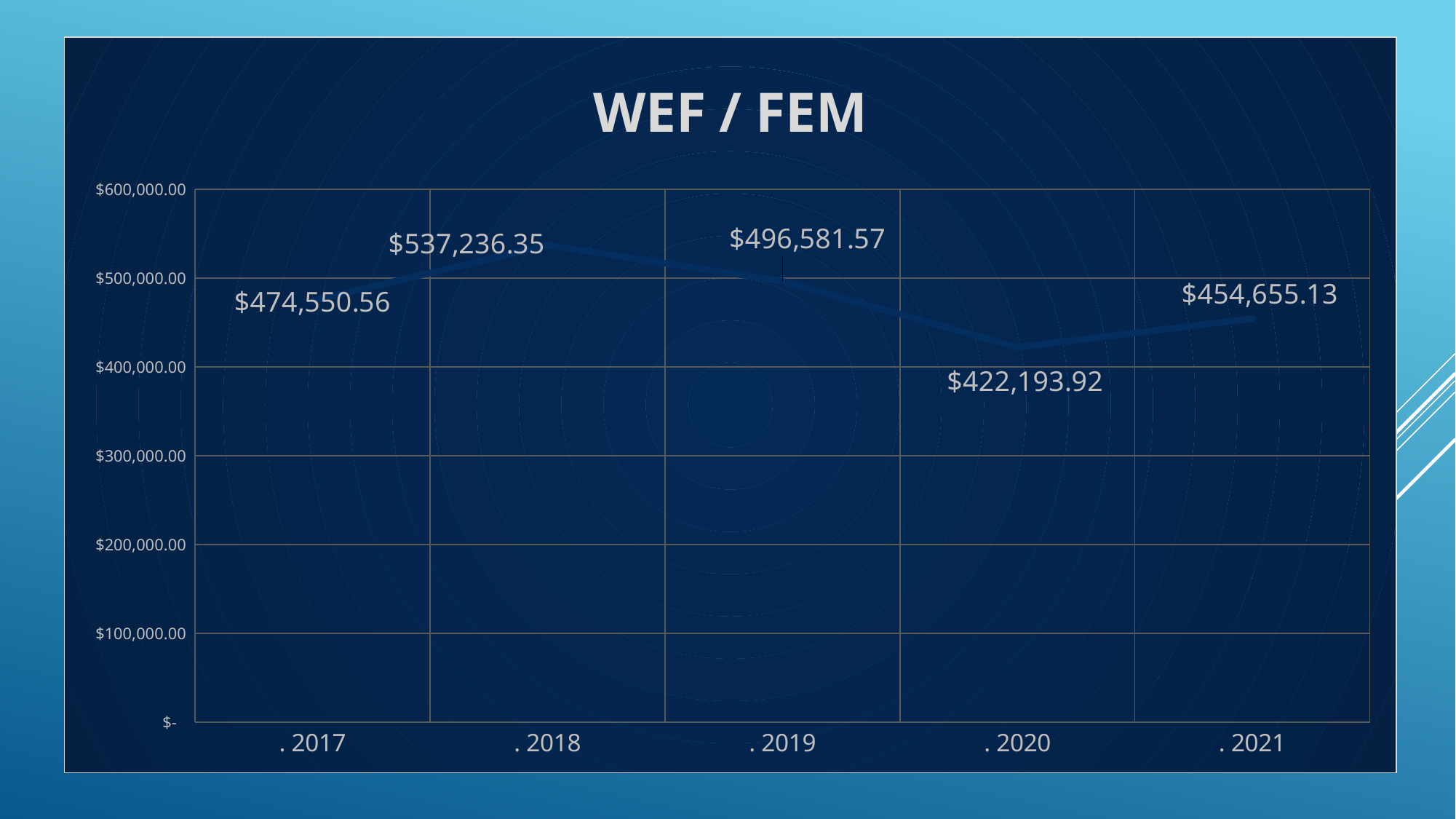
Which year has the lowest value? 2020 What is the difference between the 2019 value and the 2020 value? $74,387.65 Which year has the highest value? 2018 What is the value for 2020? $422,193.92 How many years are plotted on the x axis? 5 What is the value for 2018? $537,236.35 What is the title of the chart? WEF / FEM Does the value rise or fall from 2020 to 2021? Rise What is the difference between the 2018 value and the 2017 value? $62,685.79 What type of chart is shown on the slide? Line chart Which is larger, the value for 2019 or the value for 2021? 2019 What is the value for 2017? $474,550.56